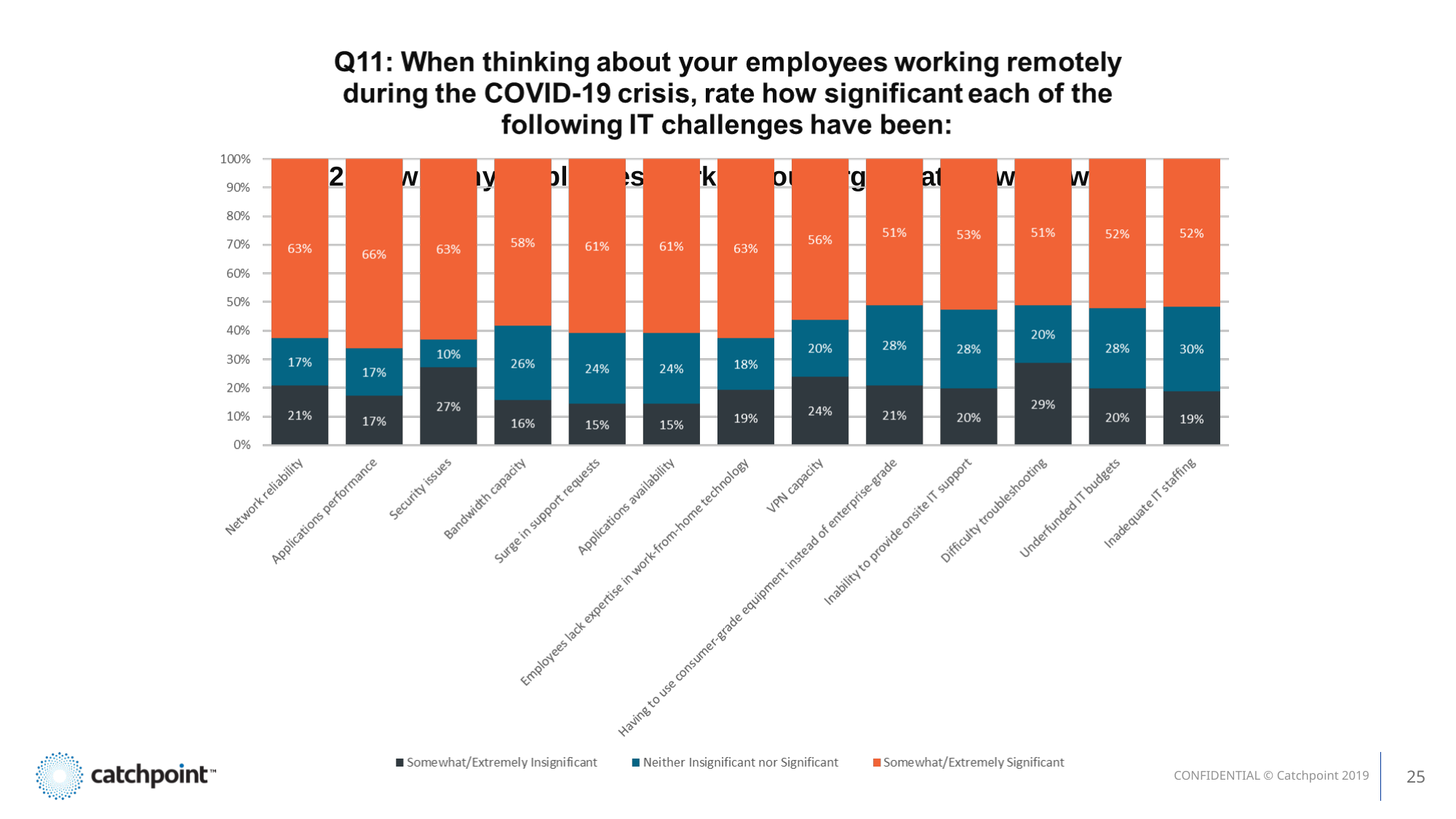
Which category has the lowest Neither Insignificant nor Significant percentage? Security issues What is the difference between the Somewhat/Extremely Significant values for Network reliability and VPN capacity? 7% Which is larger: the Somewhat/Extremely Insignificant value for Security issues or for Bandwidth capacity? Security issues Which category has the highest Neither Insignificant nor Significant percentage? Inadequate IT staffing What is the Neither Insignificant nor Significant value for Security issues? 10% How many IT challenge categories are plotted on the chart? 13 What kind of chart is shown on the slide? Stacked bar chart What is the Somewhat/Extremely Insignificant value for Difficulty troubleshooting? 29% What percentage rated Applications performance as Somewhat/Extremely Significant? 66% Which series is shown in orange in the legend? Somewhat/Extremely Significant How many series does the legend list? 3 Which category has the highest Somewhat/Extremely Significant percentage? Applications performance